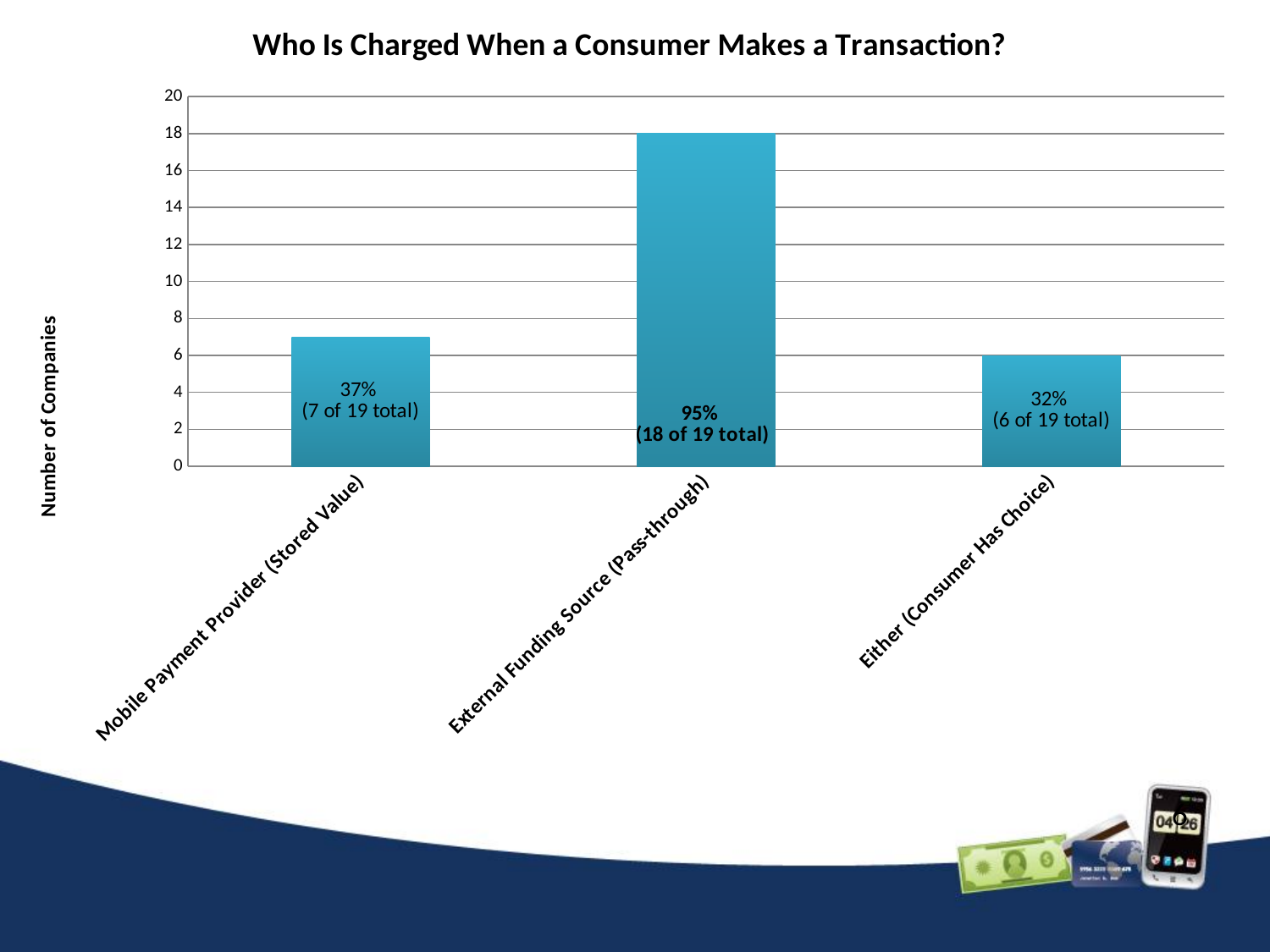
Which has more companies, Mobile Payment Provider (Stored Value) or Either (Consumer Has Choice)? Mobile Payment Provider (Stored Value) What is the difference in number of companies between External Funding Source (Pass-through) and Mobile Payment Provider (Stored Value)? 11 What type of chart is shown on the slide? bar chart What percentage is shown for External Funding Source (Pass-through)? 95% How many categories are shown on the x axis? 3 What is the title of the chart? Who Is Charged When a Consumer Makes a Transaction? What is the label of the y axis? Number of Companies Which category has the highest number of companies? External Funding Source (Pass-through) Is the value for External Funding Source (Pass-through) greater or less than 10? greater Which category has the lowest number of companies? Either (Consumer Has Choice) How many companies are counted for Mobile Payment Provider (Stored Value)? 7 What percentage is shown for Either (Consumer Has Choice)? 32%